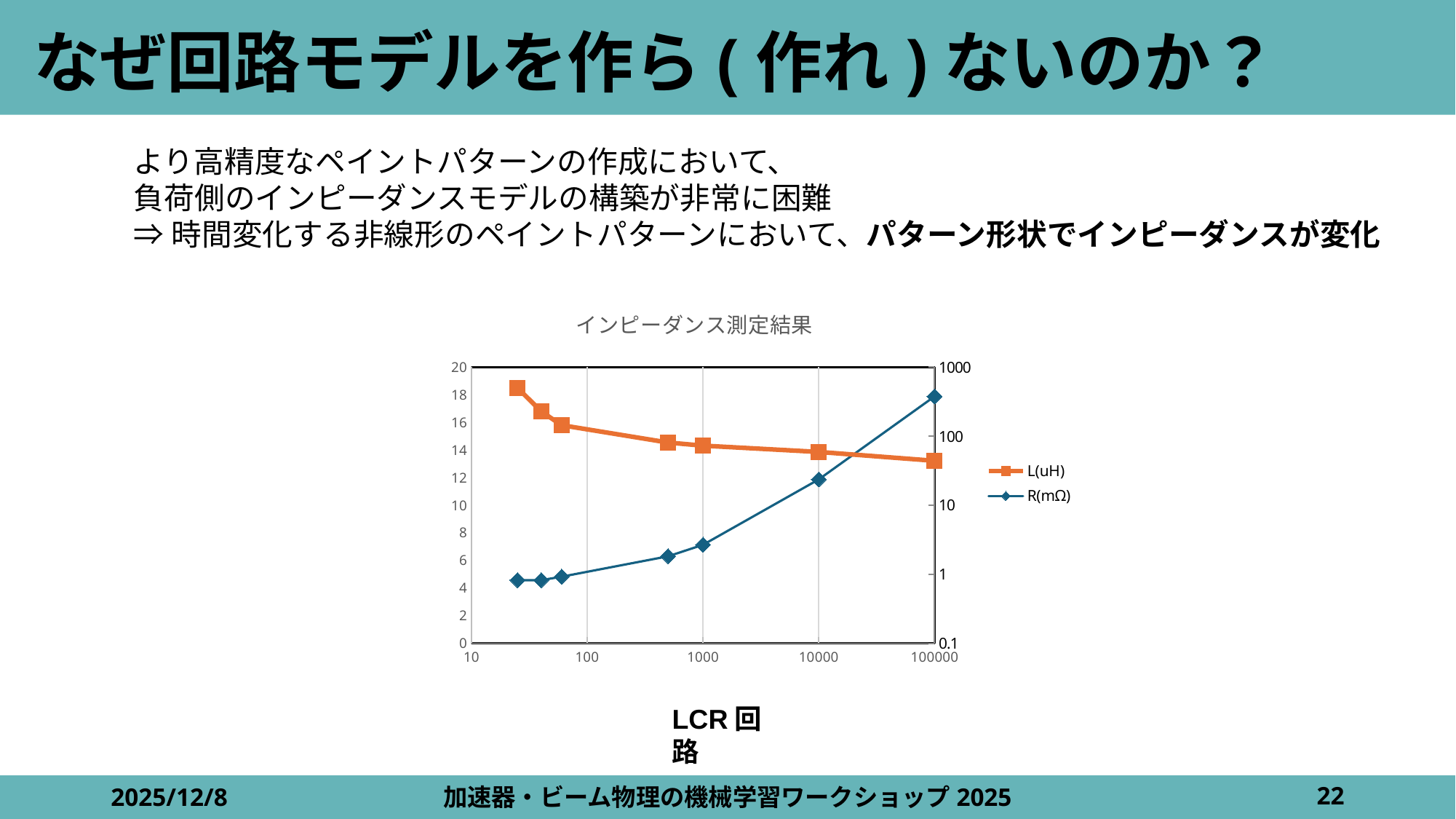
Is the value of R(mΩ) at x = 100000 greater or less than 100 on the right axis? greater What are the two series named in the legend? L(uH) and R(mΩ) Does the L(uH) series rise or fall as the x-axis value increases? fall What is the title of the chart? インピーダンス測定結果 Is the value of R(mΩ) at x = 10000 greater or less than 10 on the right axis? greater What kind of chart is shown on the slide? line chart At which x-axis value does the R(mΩ) series reach its highest value? 100000 Which is larger: the L(uH) value at the leftmost point or the L(uH) value at x = 100000? the leftmost point How many data points are plotted for the L(uH) series? 7 Is the value of L(uH) at x = 100000 greater or less than 14? less Does the R(mΩ) series rise or fall as the x-axis value increases? rise How many series does the legend list? 2